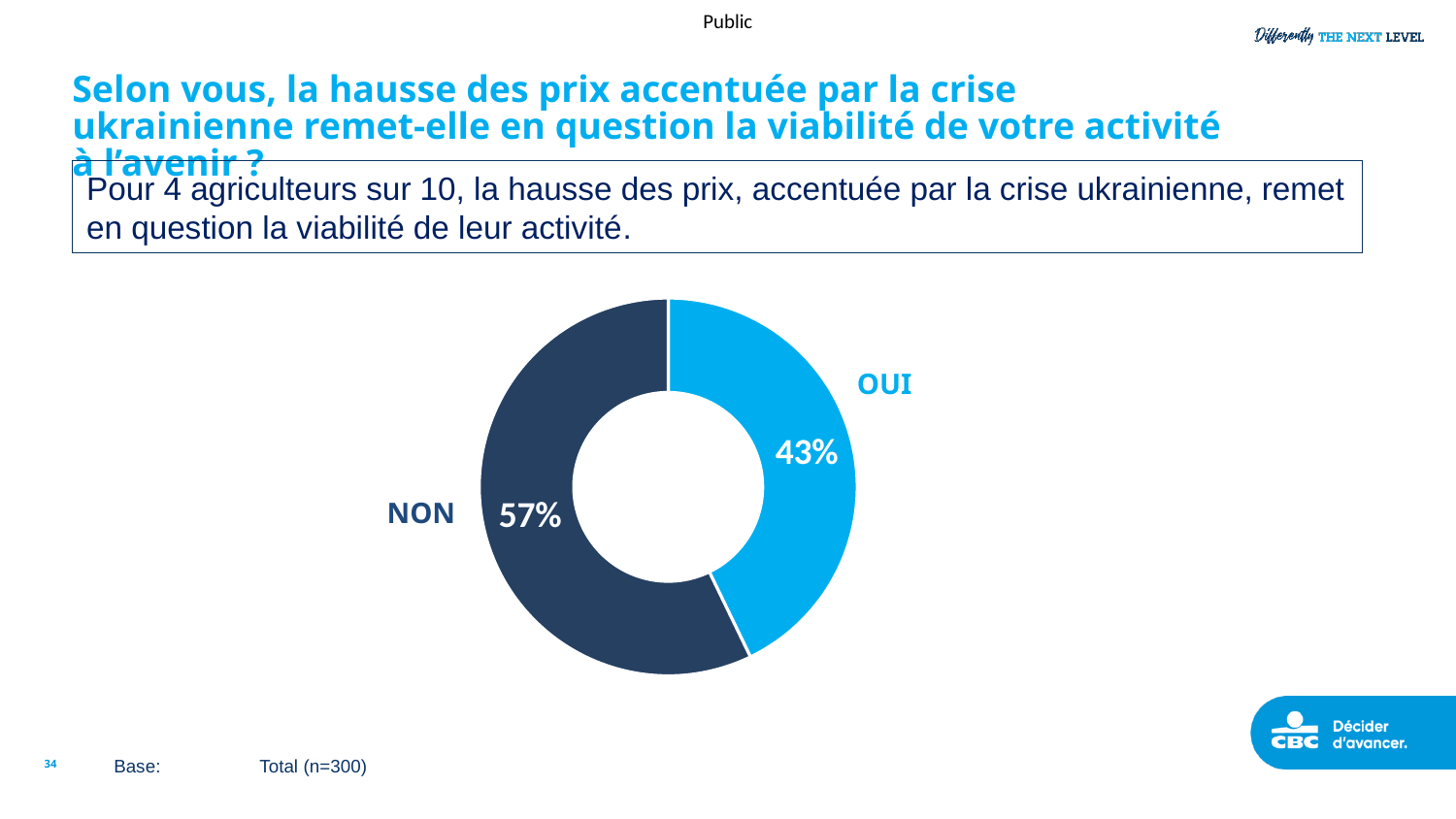
Which response has the larger share, OUI or NON? NON What is the difference in percentage points between NON and OUI? 14 What percentage of respondents answered NON? 57% What is the total of the two slices shown in the chart? 100% Which category has the largest share of the pie? NON How many categories are shown in the pie chart? 2 What kind of chart is shown on the slide? Pie chart (doughnut) What is the base (sample size) stated for the chart? Total (n=300) Is the share for OUI greater or less than 50%? less What colour is the OUI slice? Light blue What percentage of respondents answered OUI? 43% Which category has the smallest share of the pie? OUI